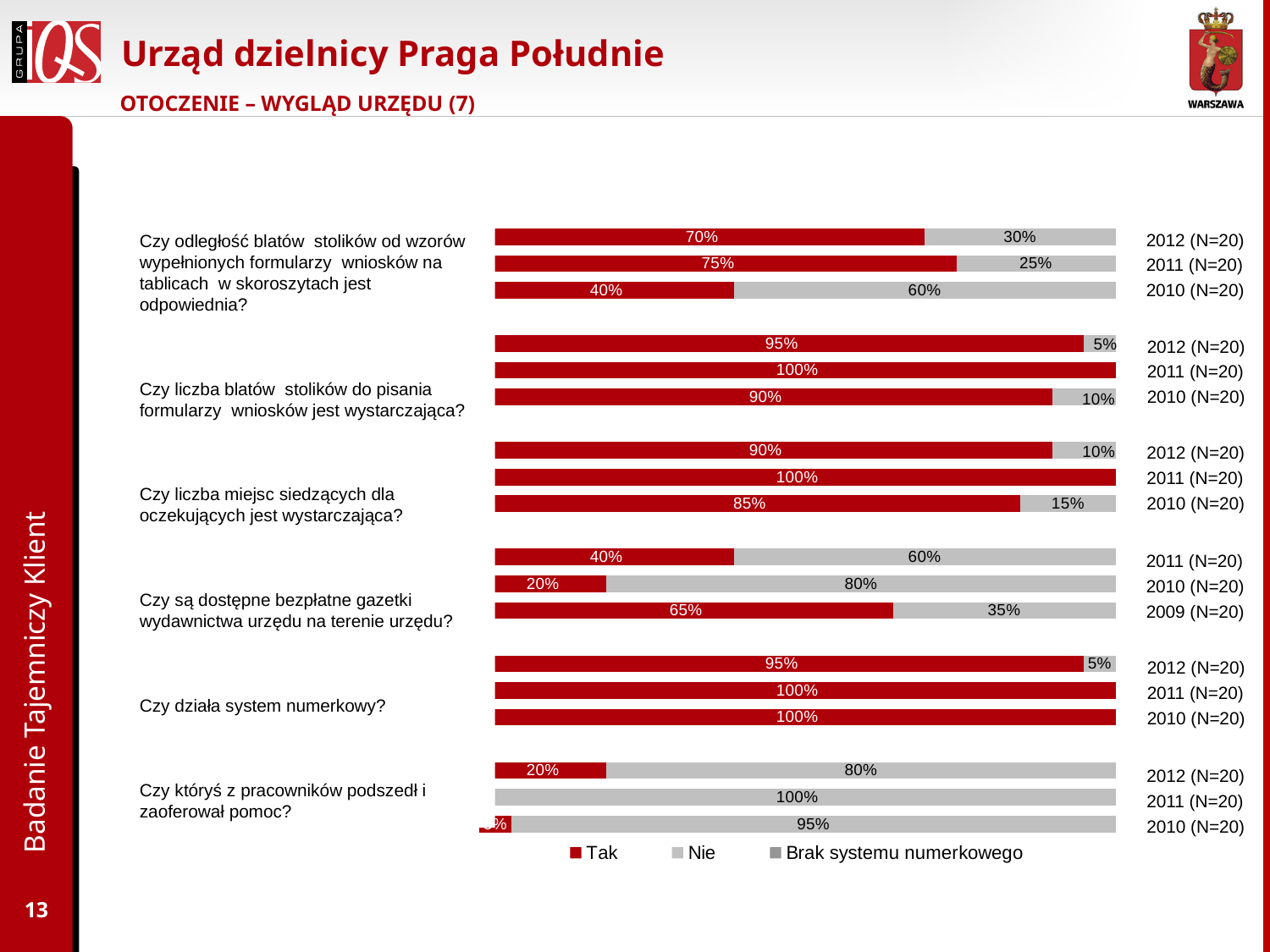
What is the 'Nie' value for 2010 for the question 'Czy odległość blatów stolików od wzorów wypełnionych formularzy wniosków na tablicach w skoroszytach jest odpowiednia?' 60% What type of chart is shown on the slide? stacked bar chart For the question 'Czy działa system numerkowy?', what is the 'Tak' value for 2012? 95% What is the sample size (N) shown for each year in the chart? N=20 For the question 'Czy są dostępne bezpłatne gazetki wydawnictwa urzędu na terenie urzędu?', which year has the lowest 'Tak' share? 2010 For the question 'Czy liczba blatów stolików do pisania formularzy wniosków jest wystarczająca?', which year has the highest 'Tak' share? 2011 For the question 'Czy są dostępne bezpłatne gazetki wydawnictwa urzędu na terenie urzędu?', what is the difference between the 'Tak' values for 2009 and 2011? 25 percentage points For the question 'Czy odległość blatów stolików od wzorów wypełnionych formularzy wniosków na tablicach w skoroszytach jest odpowiednia?', is the 'Tak' value larger in 2011 or in 2010? 2011 For the question 'Czy któryś z pracowników podszedł i zaoferował pomoc?', what is the 'Nie' value for 2011? 100% How many series does the chart legend list? 3 For the question 'Czy liczba miejsc siedzących dla oczekujących jest wystarczająca?', what is the 'Nie' value for 2010? 15% What is the 'Tak' value for 2012 for the question 'Czy odległość blatów stolików od wzorów wypełnionych formularzy wniosków na tablicach w skoroszytach jest odpowiednia?' 70%